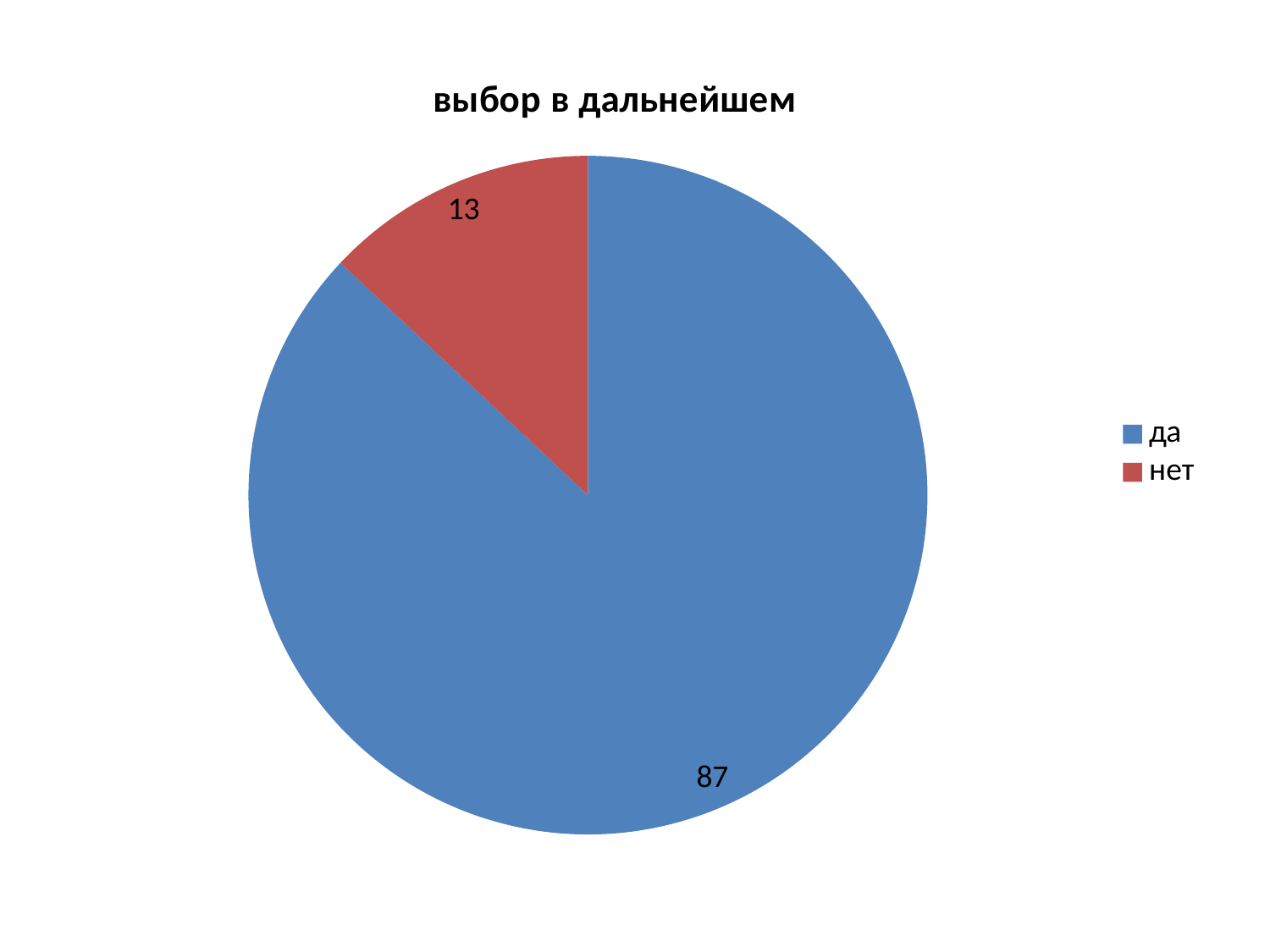
What is the value for "нет"? 13 What is the title of the chart? выбор в дальнейшем What is the value for "да"? 87 Which is larger, the value for "да" or the value for "нет"? да Which category has the smallest slice? нет What is the difference between the values for "да" and "нет"? 74 What kind of chart is shown on the slide? pie chart What colour is the slice for "нет"? red What is the total of the two slice values? 100 How many slices does the pie chart have? 2 Which category has the largest slice? да How many entries does the legend list? 2